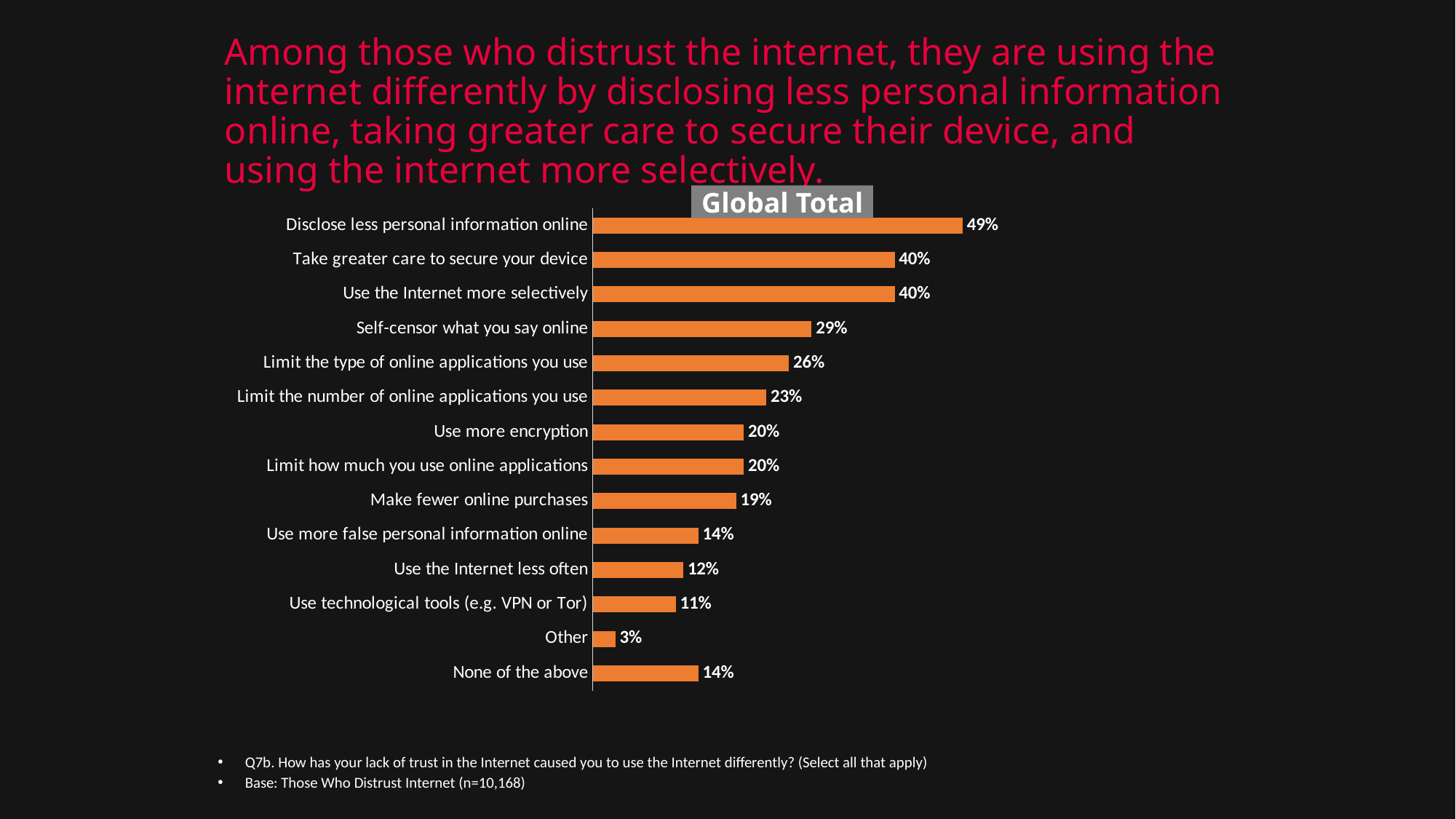
What is the difference between "Disclose less personal information online" and "Take greater care to secure your device"? 9% Which category has the lowest value? Other What is the title of the chart? Global Total Which is larger: "Make fewer online purchases" or "Use the Internet less often"? Make fewer online purchases What kind of chart is shown on the slide? Bar chart What is the value for "Use technological tools (e.g. VPN or Tor)"? 11% How many categories are shown in the chart? 14 What is the value for "Disclose less personal information online"? 49% Which category has the highest value? Disclose less personal information online What is the value for "None of the above"? 14% What is the value for "Self-censor what you say online"? 29% What is the difference between "Limit the type of online applications you use" and "Limit the number of online applications you use"? 3%